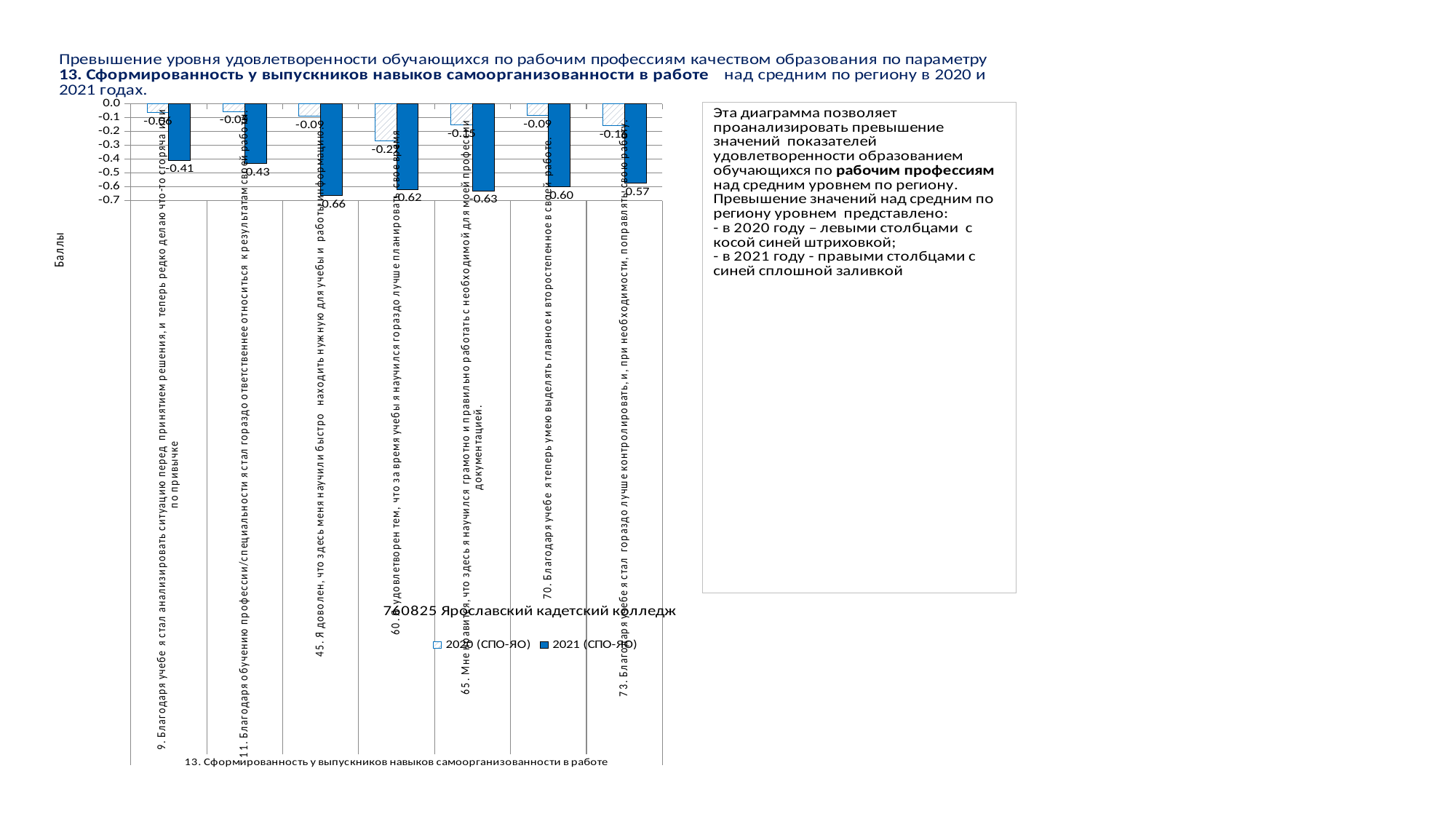
What kind of chart is shown on the slide? bar chart What is the 2021 (СПО-ЯО) value for item 65? -0.63 Which item has the highest 2021 (СПО-ЯО) value? 9 What is the difference between the 2020 and 2021 (СПО-ЯО) values for item 11? 0.38 How many categories (questionnaire items) are plotted on the chart? 7 What are the two legend entries of the chart? 2020 (СПО-ЯО) and 2021 (СПО-ЯО) What is the title shown on the chart? 760825 Ярославский кадетский колледж Which item has the lowest 2021 (СПО-ЯО) value? 45 Which is larger, the 2021 (СПО-ЯО) value for item 70 or for item 65? item 70 What is the 2021 (СПО-ЯО) value for item 9 (Благодаря учебе я стал анализировать ситуацию перед принятием решения)? -0.41 How many series does the chart legend list? 2 What is the 2020 (СПО-ЯО) value for item 45 (Я доволен, что здесь меня научили быстро находить нужную для учебы и работы информацию)? -0.09